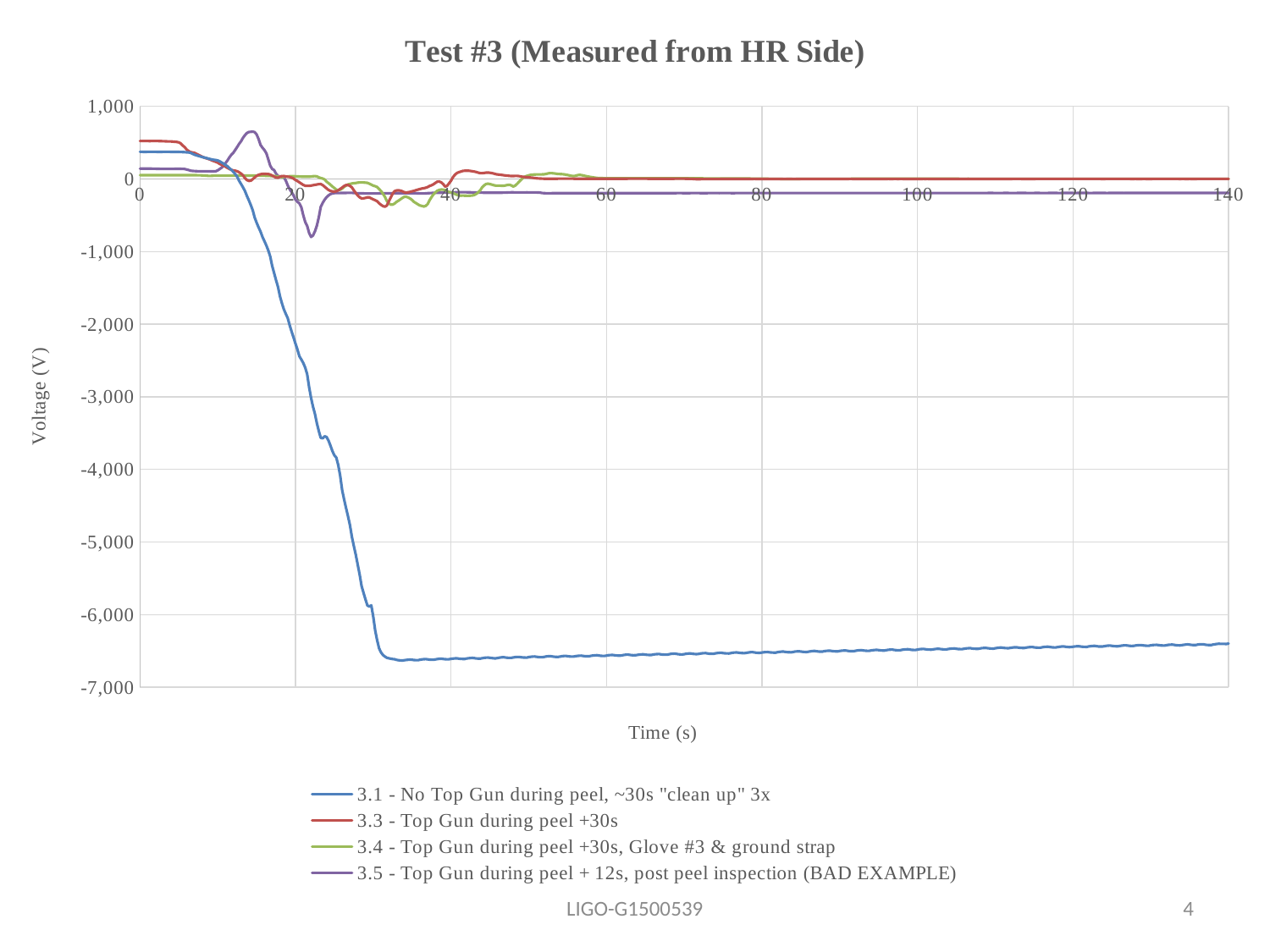
What is the title of the chart? Test #3 (Measured from HR Side) What kind of chart is shown on the slide? line chart Is the value of series 3.3 at time 100 s greater or less than -1,000? greater Is the value of series 3.1 at time 100 s greater or less than -6,000? less Does series 3.1 rise or fall between time 10 s and time 40 s? fall Which series reaches the lowest voltage on the chart? 3.1 - No Top Gun during peel, ~30s "clean up" 3x How many series does the legend list? 4 Is the value of series 3.5 at time 25 s greater or less than -1,000? greater What is the label of the vertical axis? Voltage (V) At time 100 s, which series has the larger value: 3.1 or 3.3? 3.3 - Top Gun during peel +30s